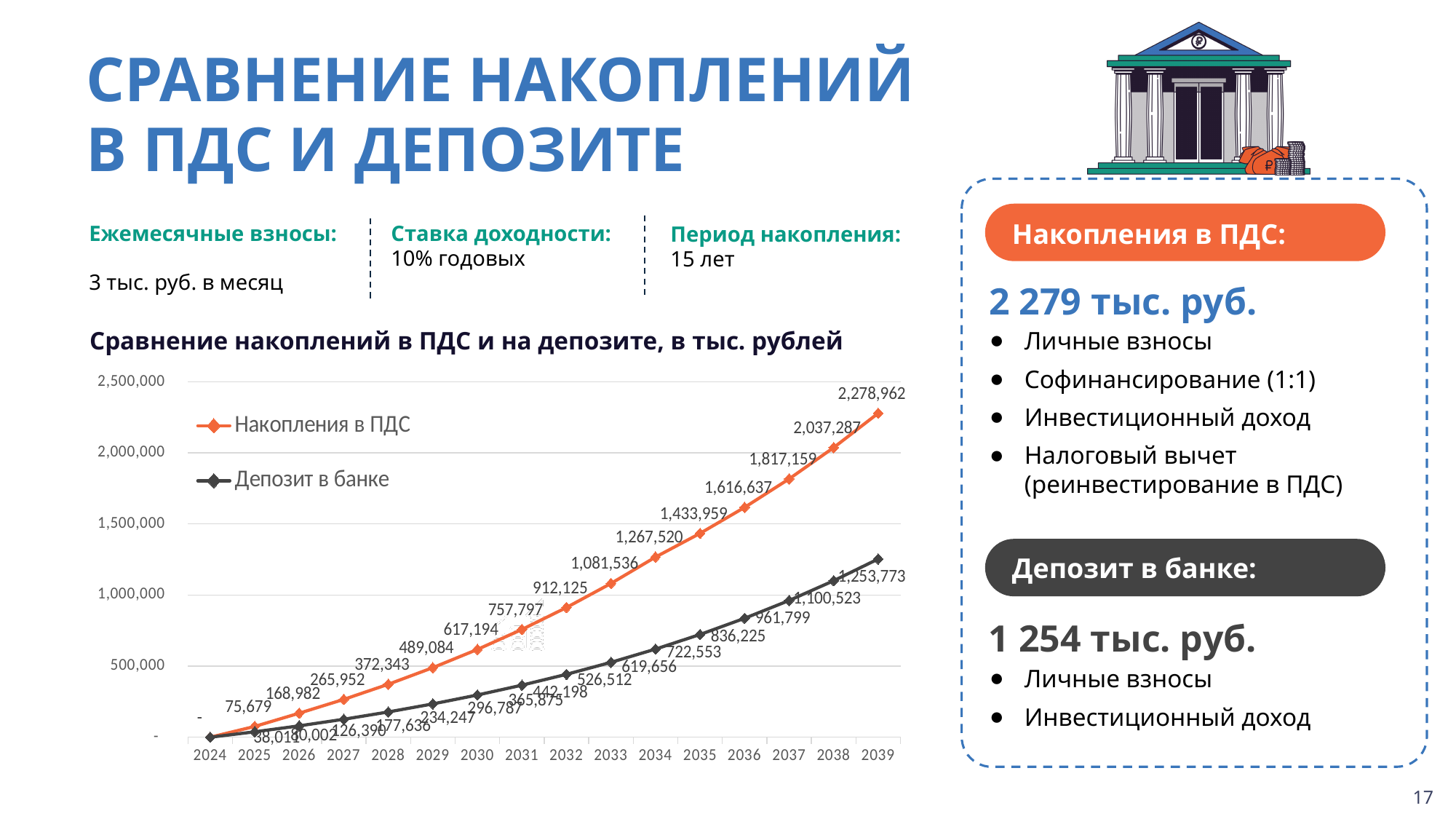
Do the values of Накопления в ПДС rise or fall from 2024 to 2039? Rise Which series has the higher value in 2037, Накопления в ПДС or Депозит в банке? Накопления в ПДС Is the value of Депозит в банке in 2037 greater or less than 1,000,000? less What is the difference between Накопления в ПДС and Депозит в банке in 2039? 1,025,189 What is the value of Накопления в ПДС in 2033? 1,081,536 What kind of chart is shown on the slide? Line chart What is the value of Накопления в ПДС in 2039? 2,278,962 How many years are shown on the x axis of the chart? 16 What is the difference between Накопления в ПДС and Депозит в банке in 2035? 711,406 What is the value of Депозит в банке in 2035? 722,553 How many series does the chart legend list? 2 What is the value of Депозит в банке in 2039? 1,253,773